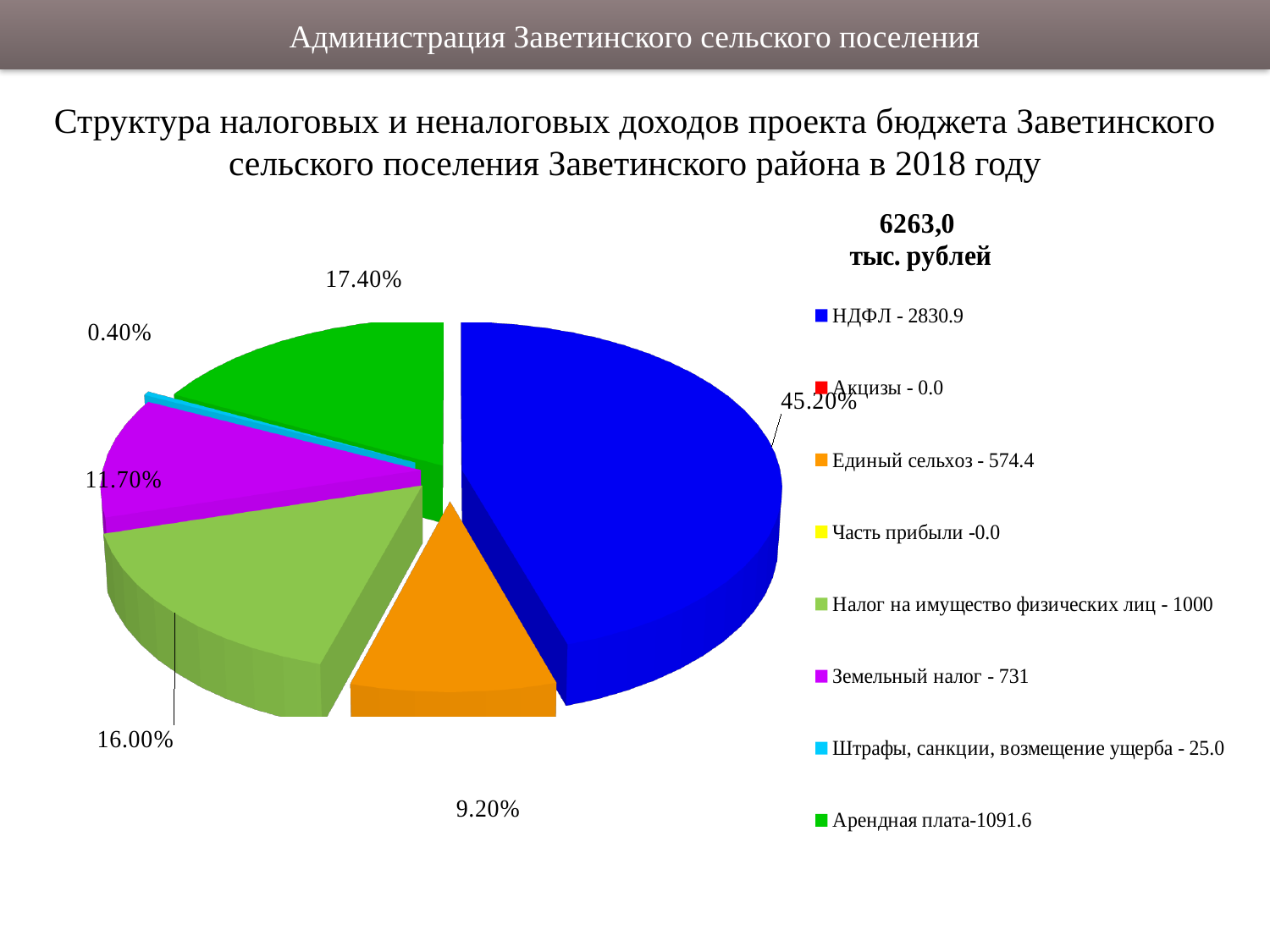
What share of the pie does Налог на имущество физических лиц have? 16.00% What share of the pie does Земельный налог have? 11.70% What share of the pie does НДФЛ have? 45.20% What is the difference in percentage points between the share for НДФЛ and the share for Арендная плата? 27.80% How many entries does the legend list? 8 What value is listed in the legend for Единый сельхоз? 574.4 Which category has the largest share of the pie? НДФЛ Which is larger, the share for Арендная плата or the share for Налог на имущество физических лиц? Арендная плата What type of chart is shown on the slide? Pie chart